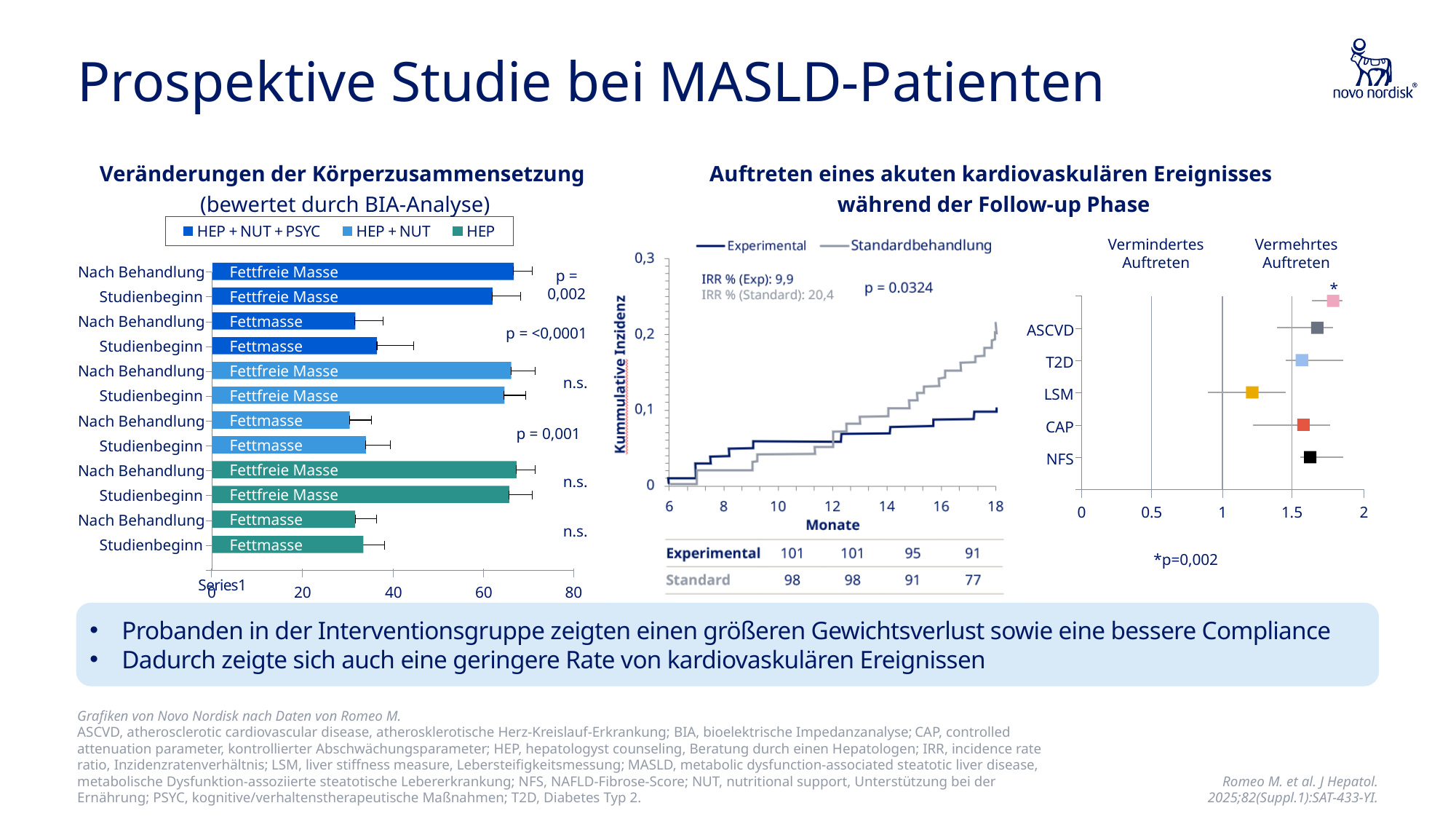
In the middle chart 'Auftreten eines akuten kardiovaskulären Ereignisses', which series has the higher cumulative incidence at 18 months: Experimental or Standardbehandlung? Standardbehandlung In the middle chart 'Auftreten eines akuten kardiovaskulären Ereignisses', does the cumulative incidence for Standardbehandlung rise or fall over the months? rise In the middle chart 'Auftreten eines akuten kardiovaskulären Ereignisses', how many patients at risk are listed for the Standard group in the last column of the table? 77 In the right forest plot, which labeled category has the lowest value? LSM What kind of chart is the left chart titled 'Veränderungen der Körperzusammensetzung'? bar chart In the left chart 'Veränderungen der Körperzusammensetzung', is the value for Fettfreie Masse 'Nach Behandlung' in the HEP + NUT + PSYC group greater or less than 60? greater In the left chart 'Veränderungen der Körperzusammensetzung', is the value for Fettmasse 'Nach Behandlung' in the HEP group greater or less than 40? less In the middle chart 'Auftreten eines akuten kardiovaskulären Ereignisses', what is the IRR % for the Experimental group? 9,9 In the middle chart 'Auftreten eines akuten kardiovaskulären Ereignisses', what is the IRR % for the Standard group? 20,4 In the left chart 'Veränderungen der Körperzusammensetzung', how many series does the legend list? 3 In the left chart 'Veränderungen der Körperzusammensetzung', what p-value is shown for the Fettmasse comparison in the HEP + NUT + PSYC group? p = <0,0001 In the left chart 'Veränderungen der Körperzusammensetzung', which is larger for the HEP + NUT group at Studienbeginn: Fettfreie Masse or Fettmasse? Fettfreie Masse